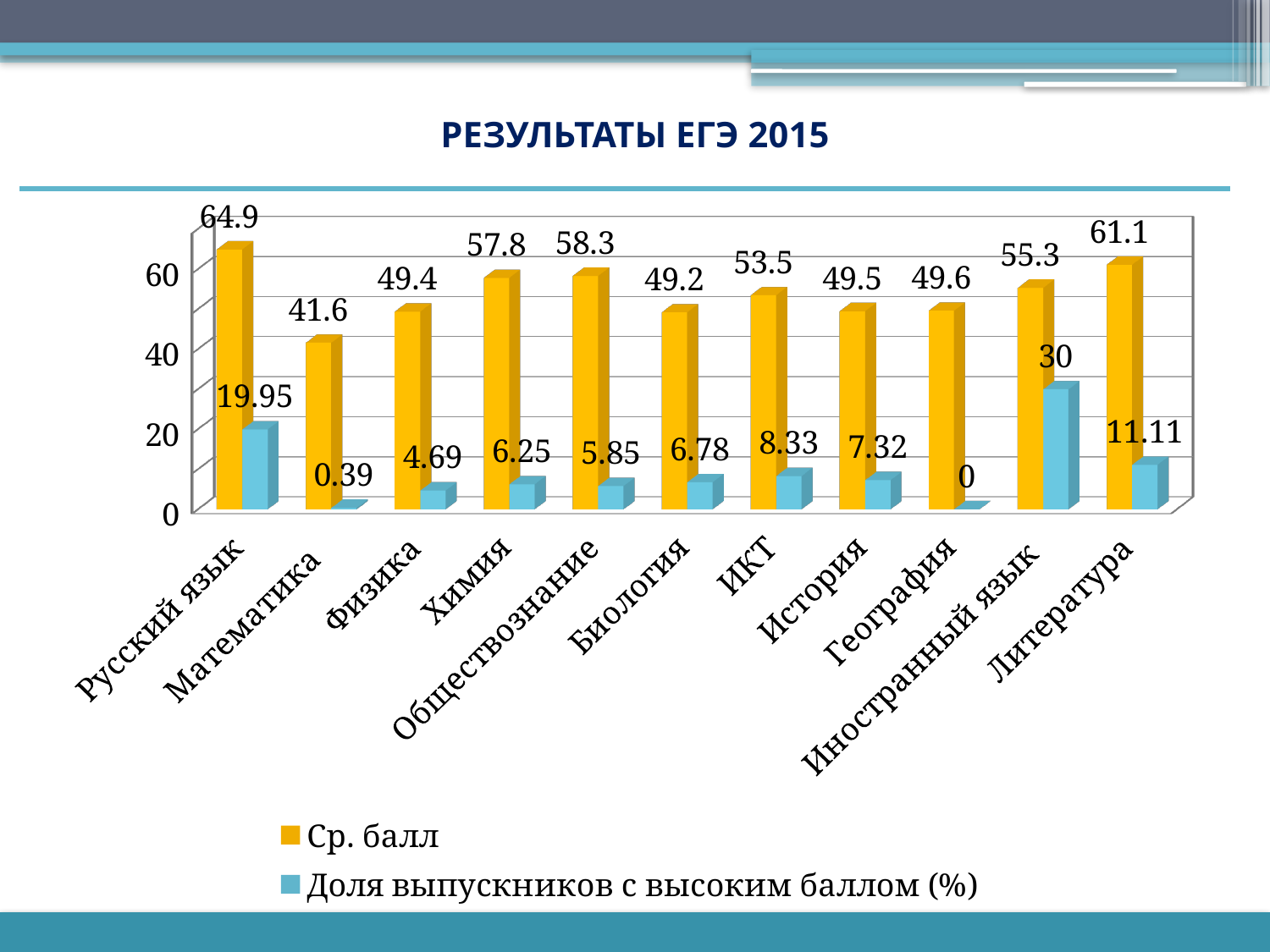
What is the share of graduates with a high score (%) for Иностранный язык? 30 What is the average score (Ср. балл) for Математика? 41.6 What is the difference between the average scores of Литература and Химия? 3.3 Which subject has the highest average score (Ср. балл)? Русский язык Is the average score (Ср. балл) for Математика greater or less than 40? greater Which subject has the lowest share of graduates with a high score (%)? География What is the title of the slide? РЕЗУЛЬТАТЫ ЕГЭ 2015 What is the average score (Ср. балл) for Русский язык? 64.9 What kind of chart is shown on the slide? bar chart Which has a higher average score (Ср. балл): Обществознание or ИКТ? Обществознание How many series does the legend list? 2 How many subjects are shown on the chart? 11